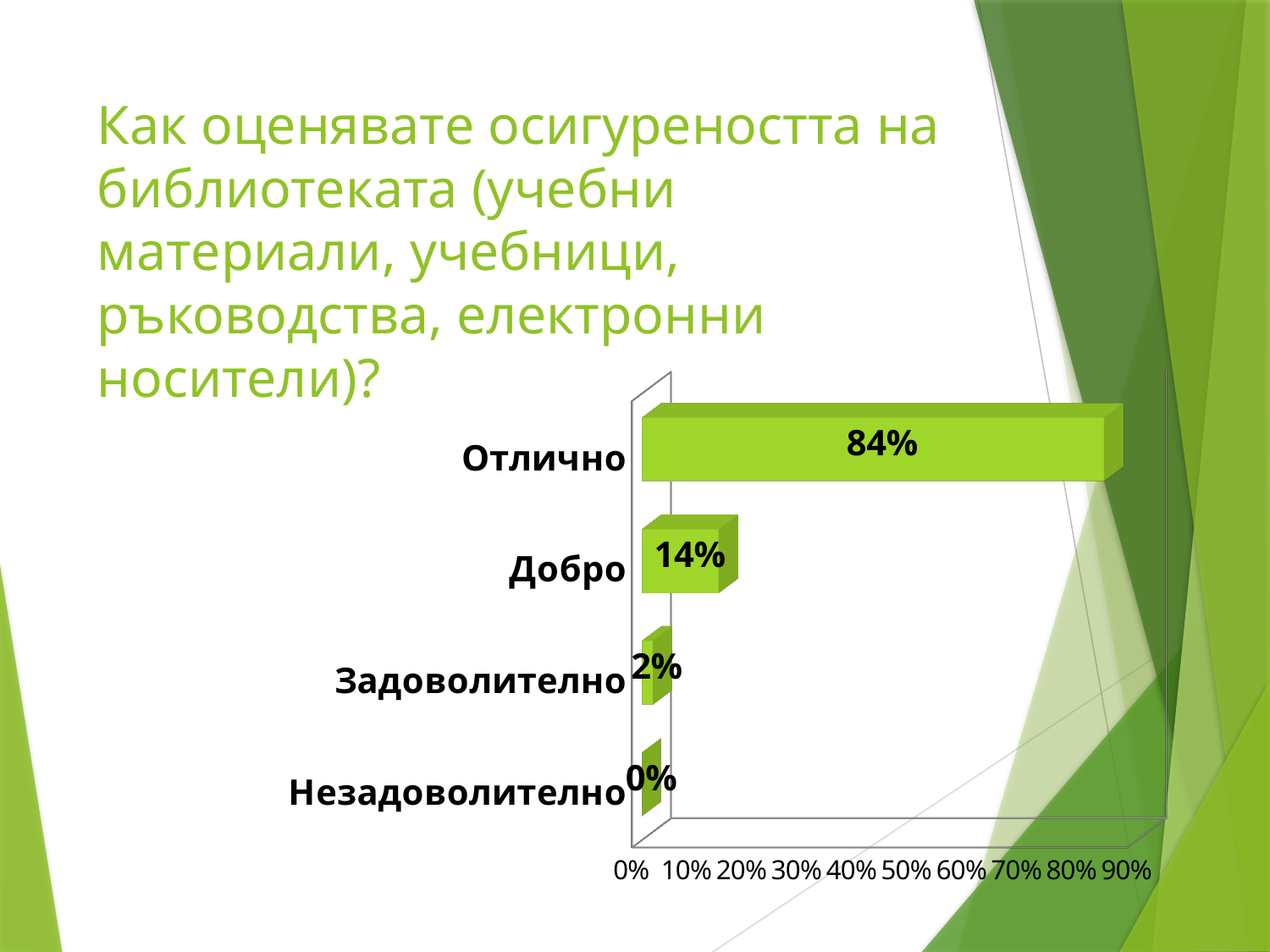
Is the value for Отлично greater or less than 80%? greater What is the difference between the values for Отлично and Добро? 70% What is the value for Отлично? 84% What kind of chart is shown on the slide? bar chart What is the value for Задоволително? 2% Which category has the highest value? Отлично What is the value for Добро? 14% What is the value for Незадоволително? 0% How many categories are shown in the chart? 4 What is the highest value shown on the horizontal axis? 90% Which category has the lowest value? Незадоволително Which is larger, the value for Добро or the value for Задоволително? Добро